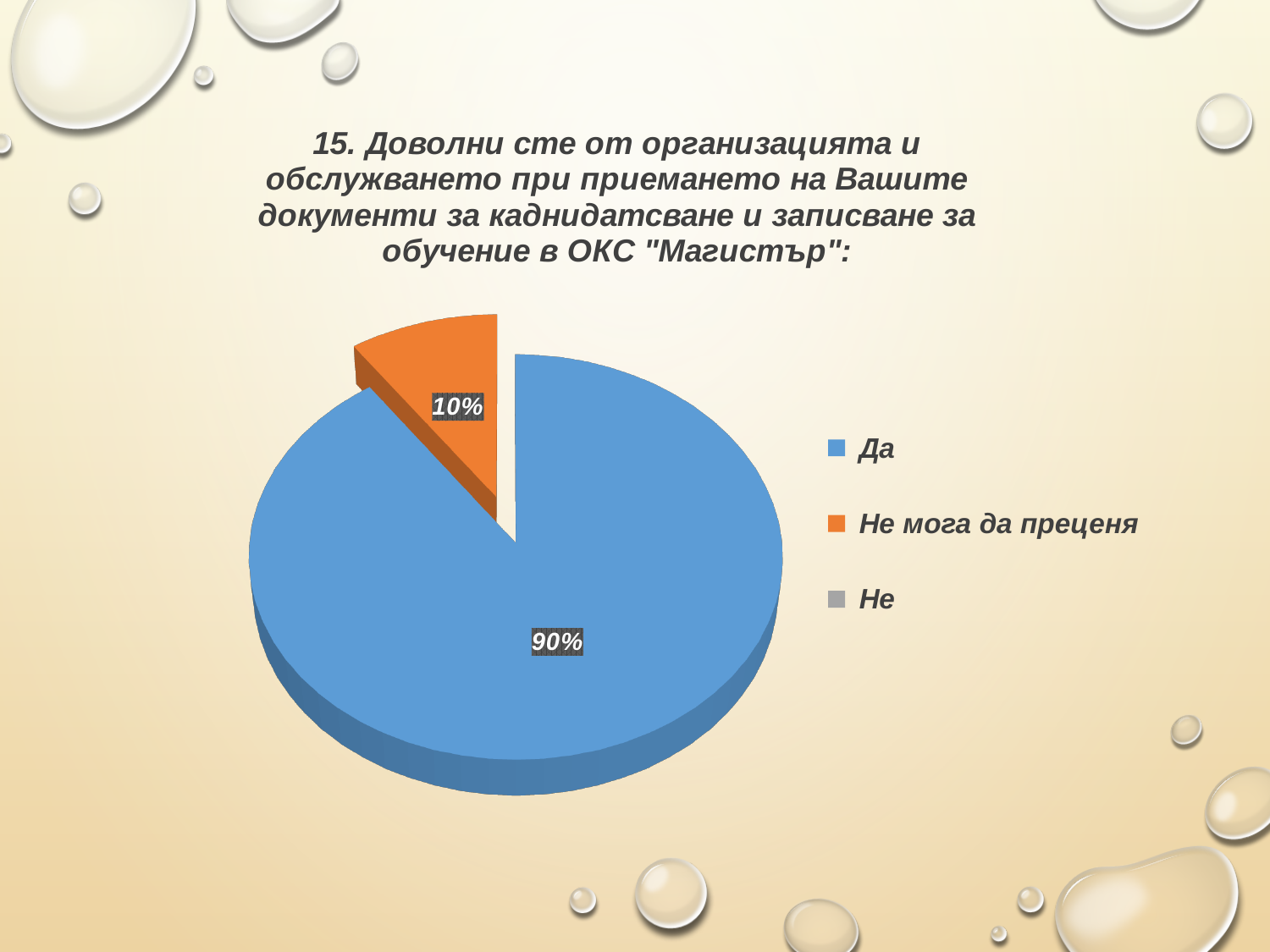
What kind of chart is shown on the slide? pie chart What share of the pie does "Не мога да преценя" have? 10% What colour is the "Да" slice? blue Which legend entry is shown in orange? Не мога да преценя What share of the pie does "Да" have? 90% How many slices with data labels are visible in the pie? 2 How many entries does the legend list? 3 What is the combined share of the "Да" and "Не мога да преценя" slices? 100% What is the difference in percentage points between the "Да" slice and the "Не мога да преценя" slice? 80 Which category has the largest slice of the pie? Да Which of the two labelled slices is smaller, "Да" or "Не мога да преценя"? Не мога да преценя Which is larger, the "Да" slice or the "Не мога да преценя" slice? Да